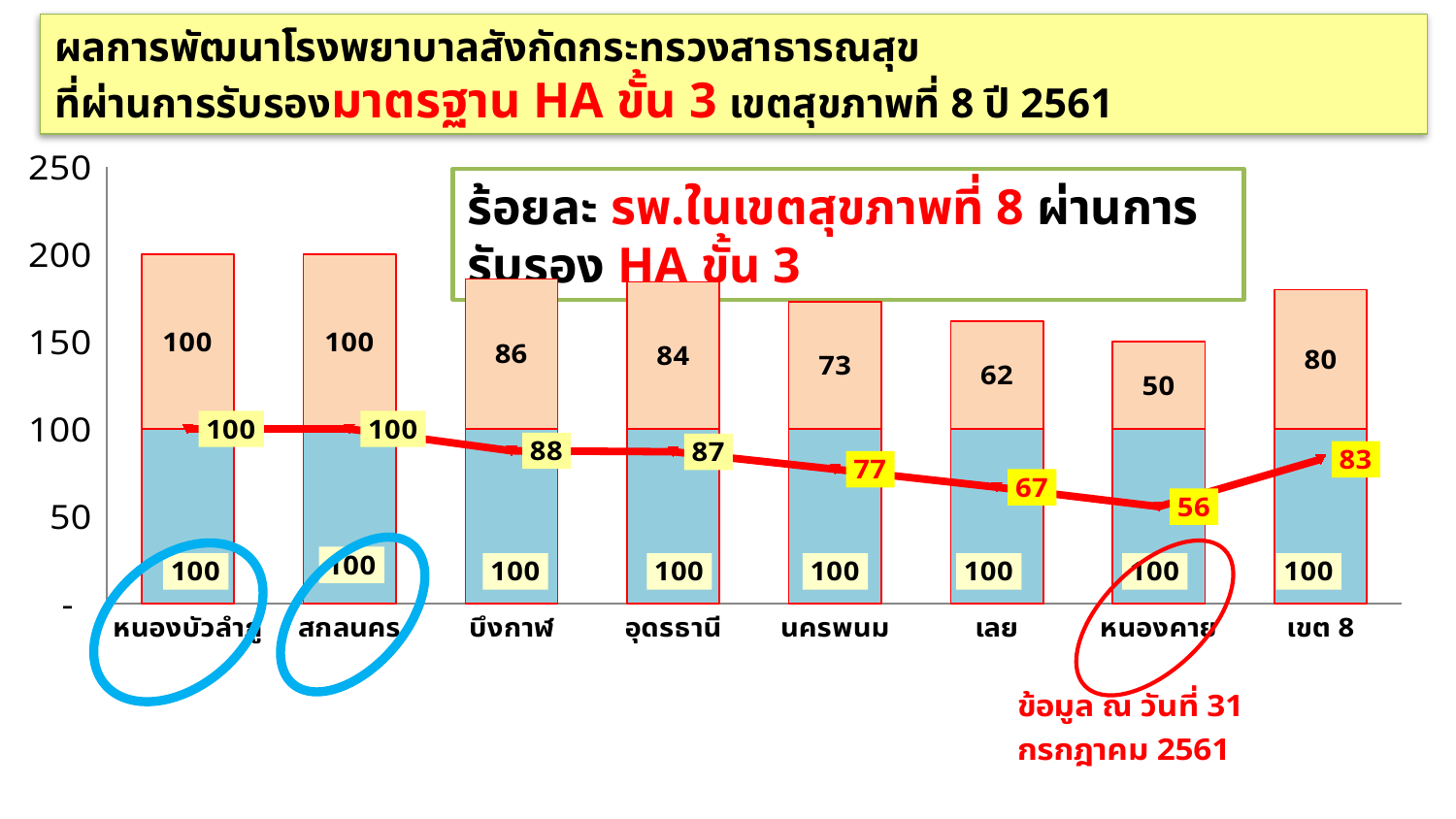
Which category has the lowest orange (top) segment value? หนองคาย What kind of chart is this? Stacked bar chart with a line overlay Which category has the lowest value on the red line? หนองคาย What is the difference between the orange segment values for อุดรธานี and เลย? 22 Which is larger, the red line value for บึงกาฬ or for หนองคาย? บึงกาฬ What is the value shown on the red line for นครพนม? 77 What is the value of the orange (top) segment for บึงกาฬ? 86 What is the value of the blue (bottom) segment for เลย? 100 What is the total of the stacked bar for นครพนม? 173 How many categories are shown on the x axis? 8 What is the value shown on the red line for เขต 8? 83 What is the value of the orange (top) segment for หนองคาย? 50